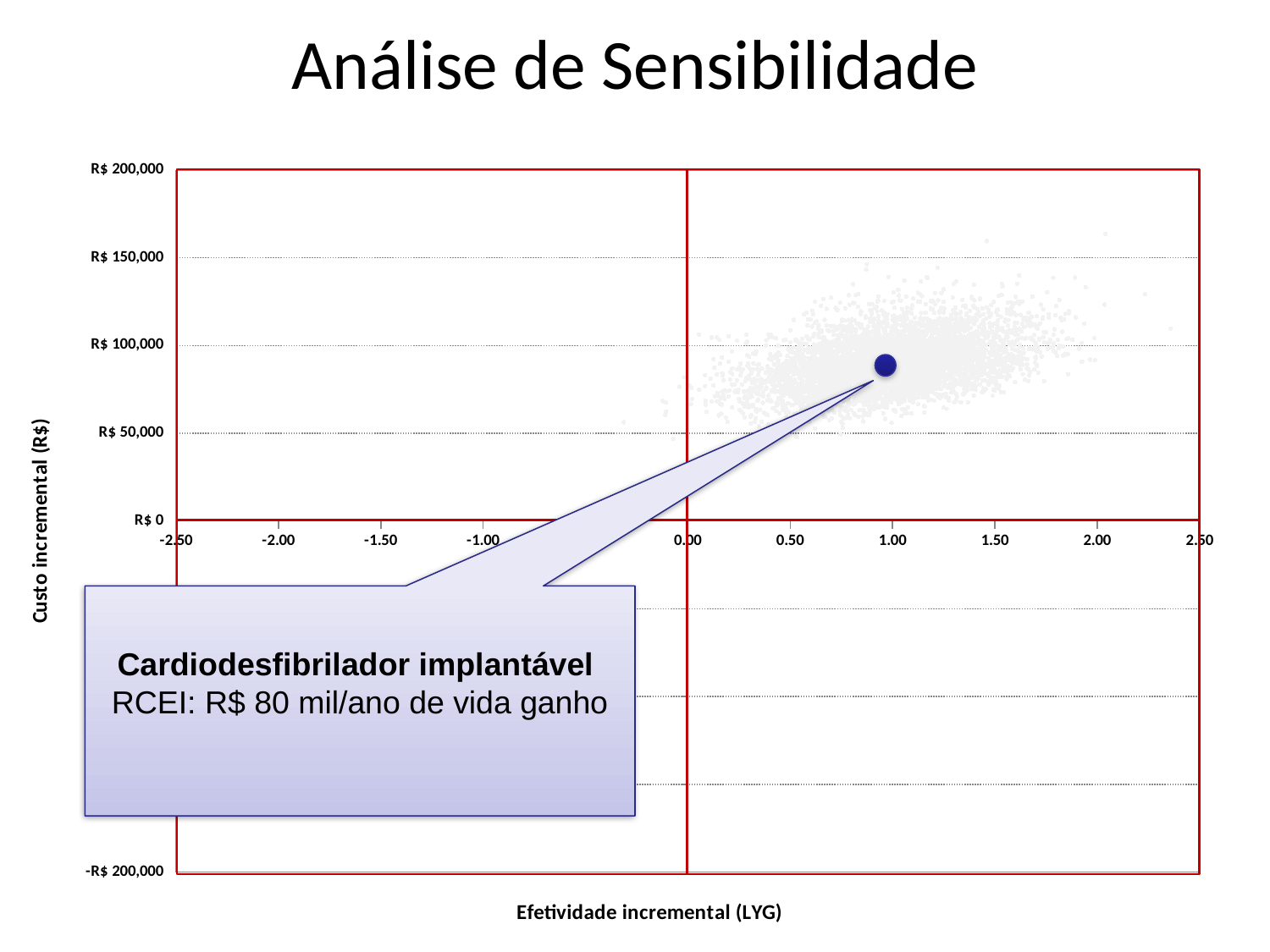
Is the incremental effectiveness (LYG) of the highlighted blue point greater or less than 1.50? less Is the incremental effectiveness (LYG) of the highlighted blue point greater or less than 0.50? greater What kind of chart is shown on the slide? Scatter chart According to the callout, what is the RCEI for the implantable cardioverter-defibrillator? R$ 80 mil/ano de vida ganho Is the incremental cost of the highlighted blue point greater or less than R$ 50,000? greater What is the minimum value shown on the horizontal axis? -2.50 What is the title of the slide's chart? Análise de Sensibilidade What is the maximum value shown on the vertical axis? R$ 200,000 What is the label of the horizontal axis? Efetividade incremental (LYG)